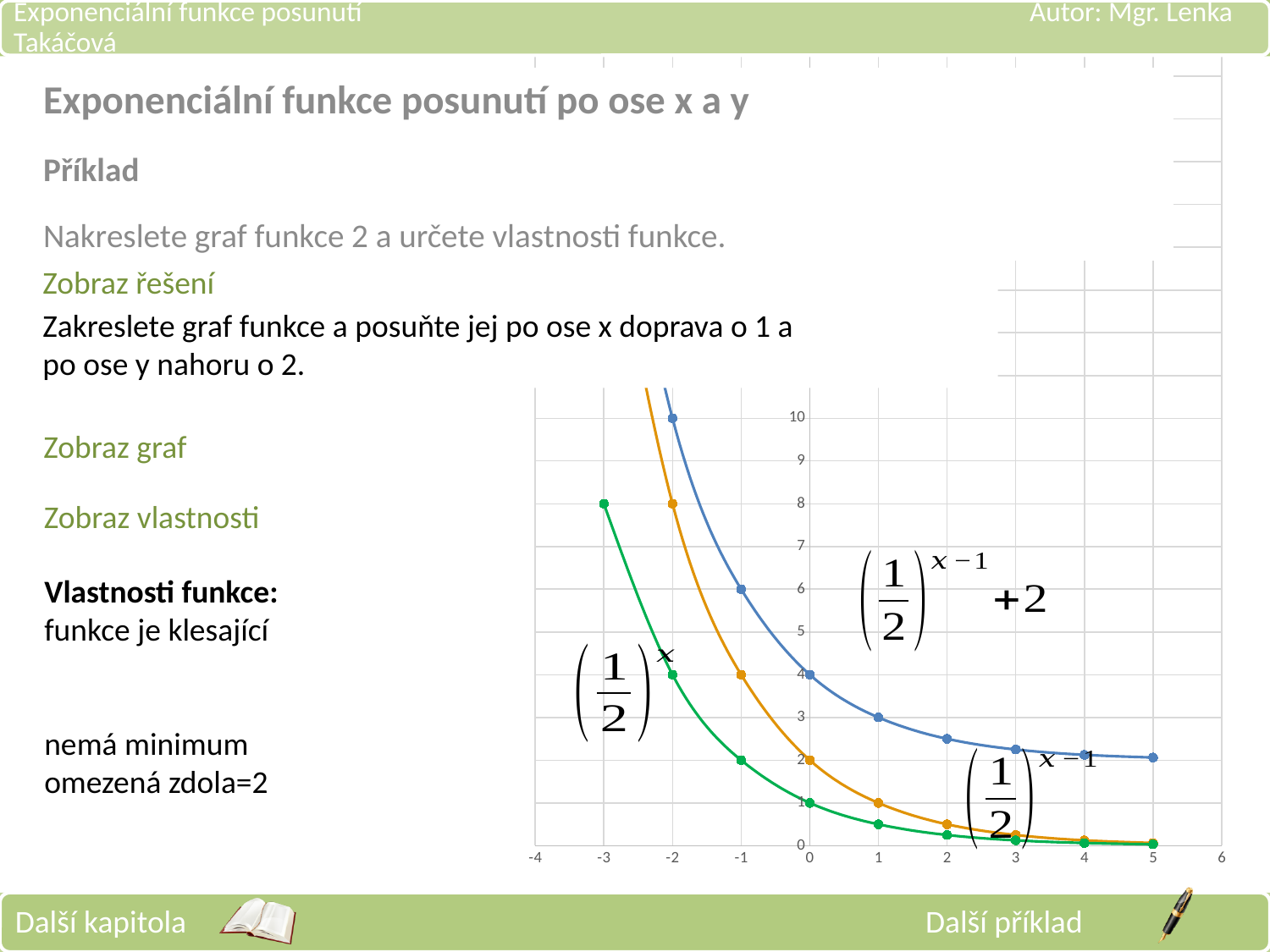
Which curve has the highest value at x = 1? blue curve (1/2)^(x-1)+2 What is the value of the orange curve (1/2)^(x-1) at x = -2? 8 What is the value of the blue curve (1/2)^(x-1)+2 at x = 0? 4 What is the value of the green curve (1/2)^x at x = -3? 8 What is the value of the blue curve (1/2)^(x-1)+2 at x = -2? 10 How many curves are plotted on the chart? 3 What is the difference between the blue curve and the green curve at x = 0? 3 Is the value of the blue curve at x = 5 greater or less than 1? greater Do the values of the curves rise or fall as x increases? fall At x = 0, which curve has the higher value, the blue curve or the green curve? blue curve What kind of chart is shown on the slide? line chart What is the value of the green curve (1/2)^x at x = 0? 1